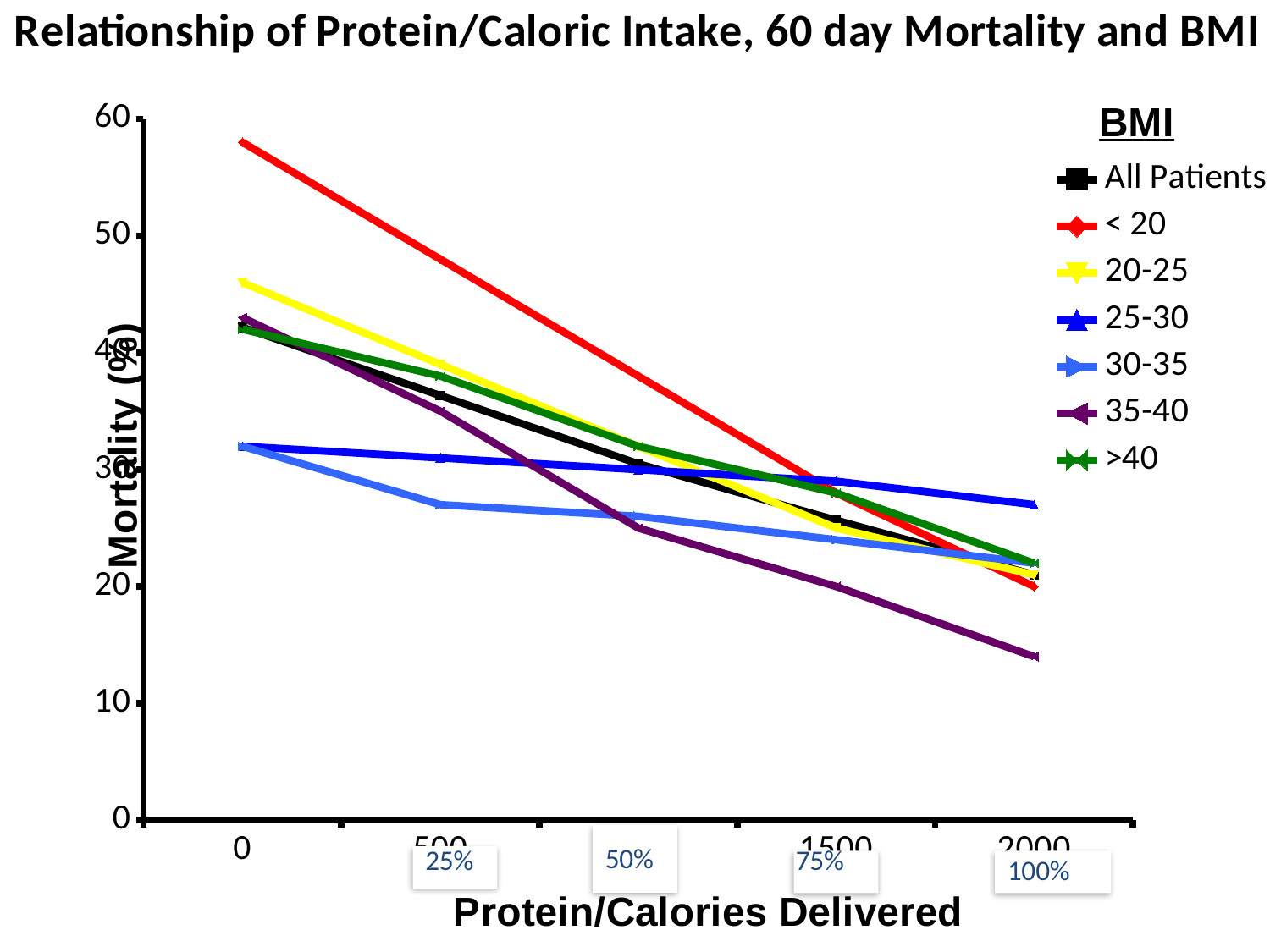
Is the mortality value for the < 20 BMI series at 0 protein/calories delivered greater or less than 50? greater Is the mortality value for the 25-30 BMI series at 0 protein/calories delivered greater or less than 40? less What kind of chart is shown on the slide? line chart At 0 protein/calories delivered, which series has higher mortality: 20-25 or 30-35? 20-25 What is the title of the chart? Relationship of Protein/Caloric Intake, 60 day Mortality and BMI How many series does the legend list? 7 Which BMI series has the lowest mortality at 2000 protein/calories delivered? 35-40 At 2000 protein/calories delivered, which series has higher mortality: 25-30 or 35-40? 25-30 Which BMI series has the highest mortality at 0 protein/calories delivered? < 20 What is the heading shown above the legend entries? BMI Does mortality for the < 20 BMI series rise or fall as protein/calories delivered increases? fall Is the mortality value for the 35-40 BMI series at 2000 protein/calories delivered greater or less than 20? less